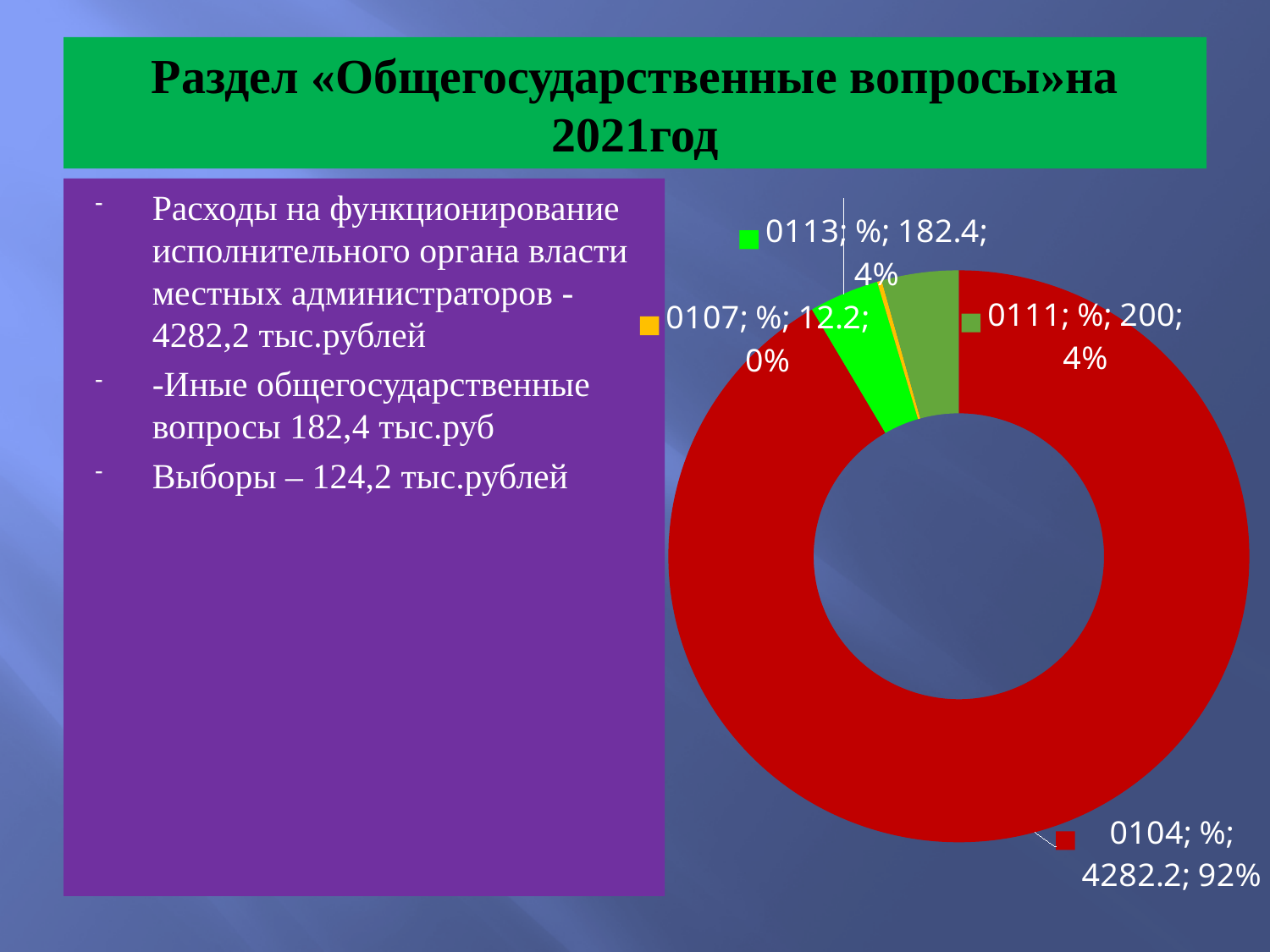
What percentage share is labelled for category 0113? 4% Which category has the smallest slice in the doughnut chart? 0107 What is the value shown for category 0111? 200 Which is larger, the value for 0111 or the value for 0113? 0111 What is the difference between the values for 0111 and 0113? 17.6 What kind of chart is shown on the slide? doughnut chart What is the value shown for category 0107? 12.2 What is the value shown for category 0113? 182.4 What percentage share of the doughnut does category 0104 have, as labelled? 92% What is the value shown for category 0104? 4282.2 How many categories (slices) does the doughnut chart show? 4 Which category has the largest slice in the doughnut chart? 0104